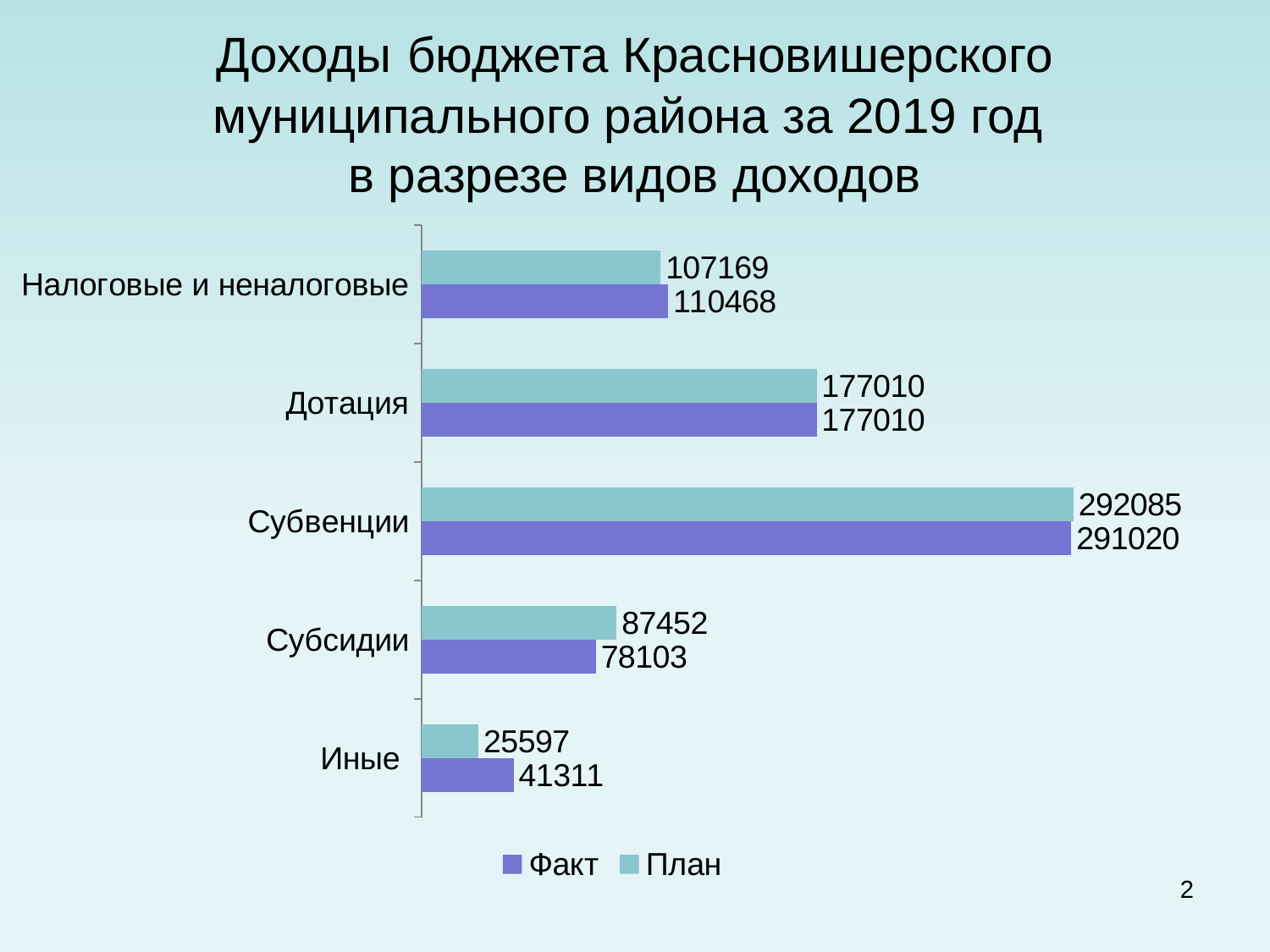
Which category has the highest Факт value? Субвенции What kind of chart is shown on the slide? Bar chart What is the difference between the Факт and План values for Иные? 15714 What is the План value for Субвенции? 292085 How many series does the legend list? 2 What is the Факт value for Субсидии? 78103 Which series is shown in purple? Факт Which category has the lowest План value? Иные Which is larger for Налоговые и неналоговые, the Факт value or the План value? Факт How many categories are shown on the chart? 5 What is the Факт value for Иные? 41311 What is the difference between the План and Факт values for Субсидии? 9349